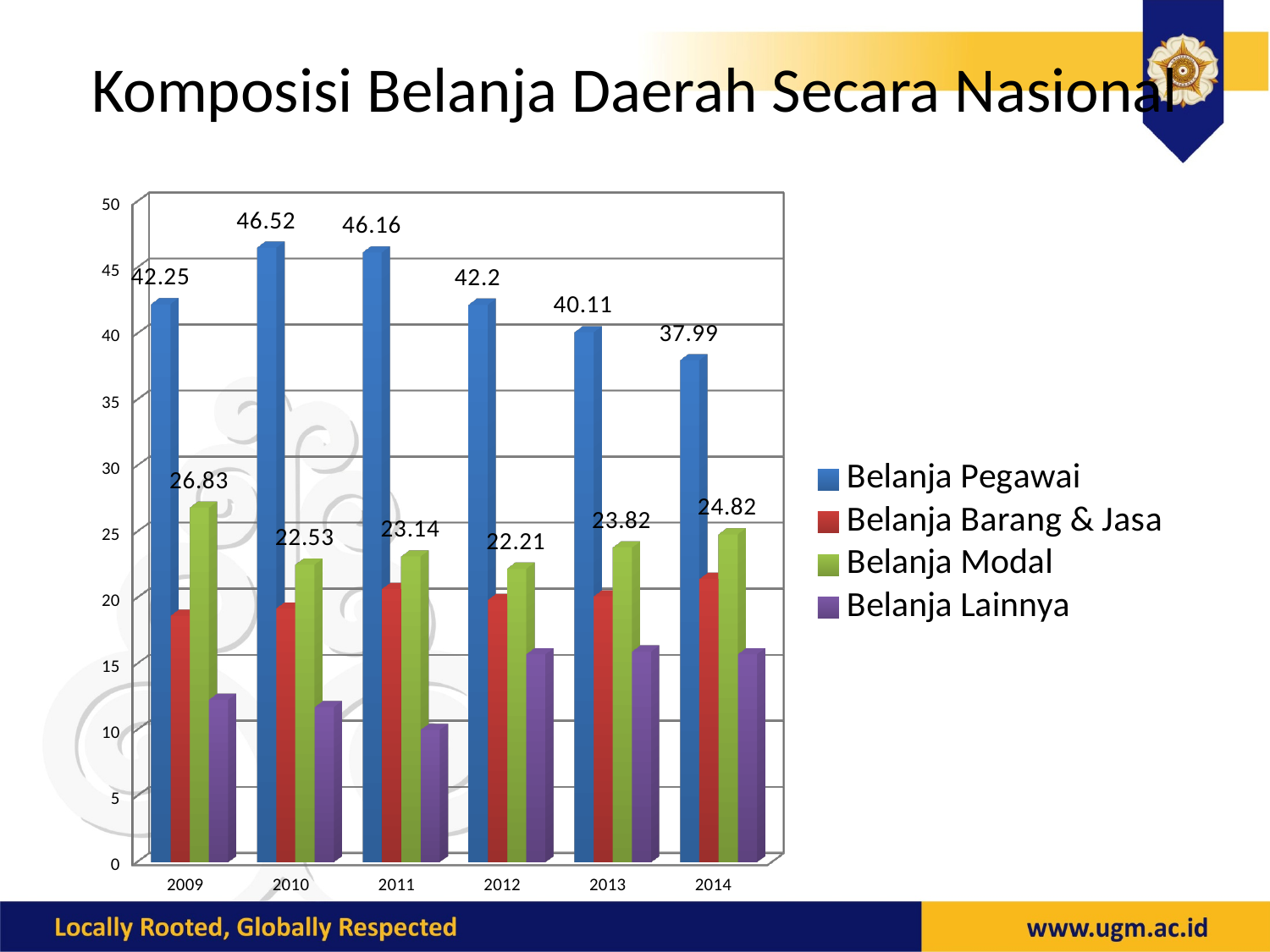
How many series does the legend list? 4 What is the value of Belanja Modal in 2009? 26.83 Is the value for Belanja Lainnya in 2011 greater or less than 15? less In which year is Belanja Modal lowest? 2012 In which year is Belanja Pegawai highest? 2010 What is the value of Belanja Pegawai in 2010? 46.52 How many years are shown on the x axis? 6 What is the difference between Belanja Pegawai in 2010 and in 2014? 8.53 Does Belanja Pegawai rise or fall from 2011 to 2014? fall What kind of chart is shown on the slide? bar chart What is the value of Belanja Pegawai in 2014? 37.99 Which is larger, Belanja Modal in 2013 or Belanja Modal in 2014? Belanja Modal in 2014